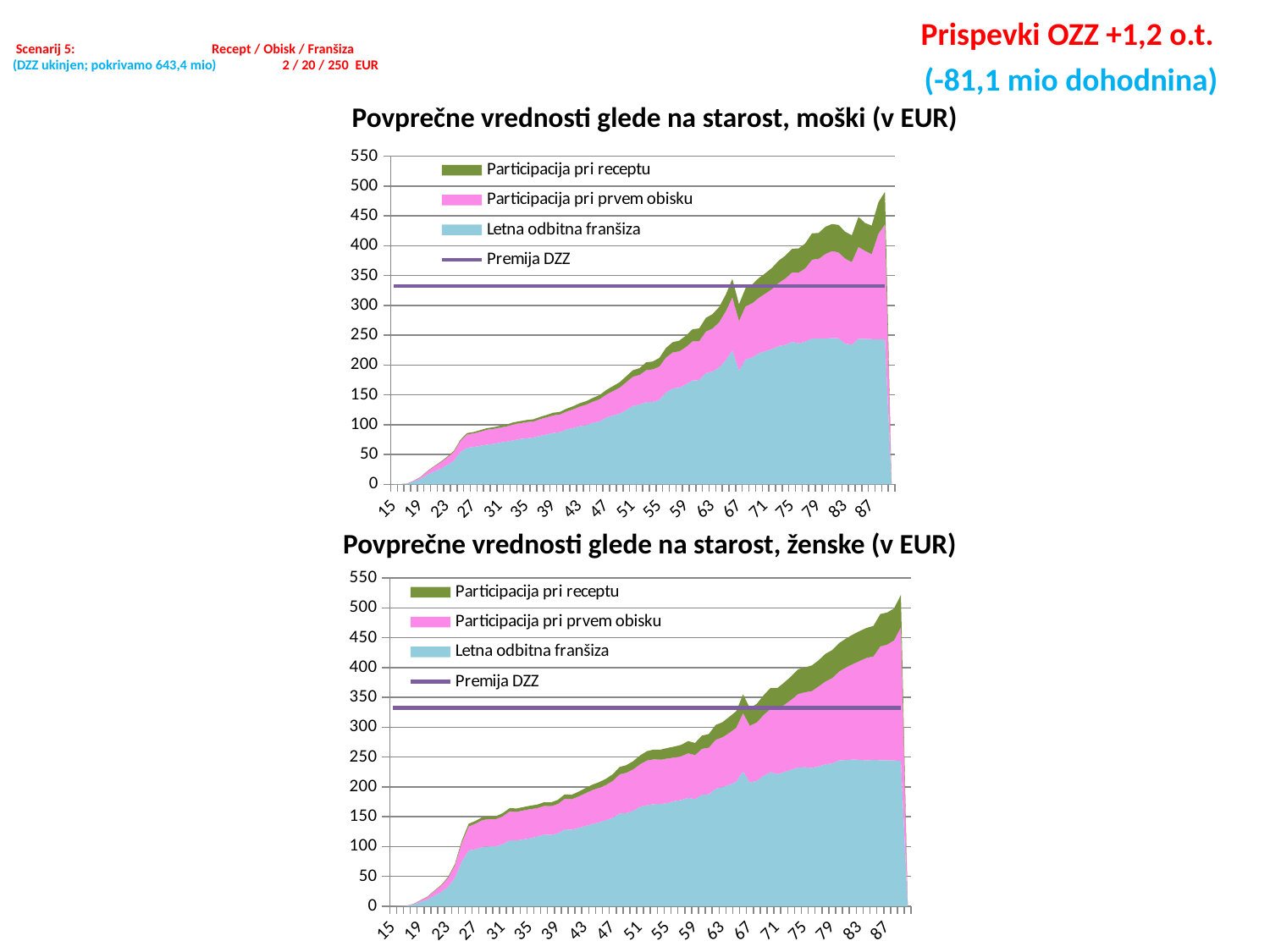
In the top chart (moški), is the value of the Premija DZZ line greater or less than 300? greater In the top chart (moški), do the stacked values generally rise or fall as age increases along the x axis? rise How many series does the legend list in the bottom chart (ženske)? 4 What is the title of the bottom chart? Povprečne vrednosti glede na starost, ženske (v EUR) In the bottom chart (ženske), is the value of the Premija DZZ line greater or less than 350? less In the top chart (moški), is the total stacked value at age 87 greater or less than 400? greater How many series does the legend list in the top chart (moški)? 4 In the top chart (moški), which series is drawn as a flat horizontal line? Premija DZZ What kind of chart is the top chart titled 'Povprečne vrednosti glede na starost, moški (v EUR)'? Stacked area chart with a line In the bottom chart (ženske), do the stacked values generally rise or fall as age increases along the x axis? rise